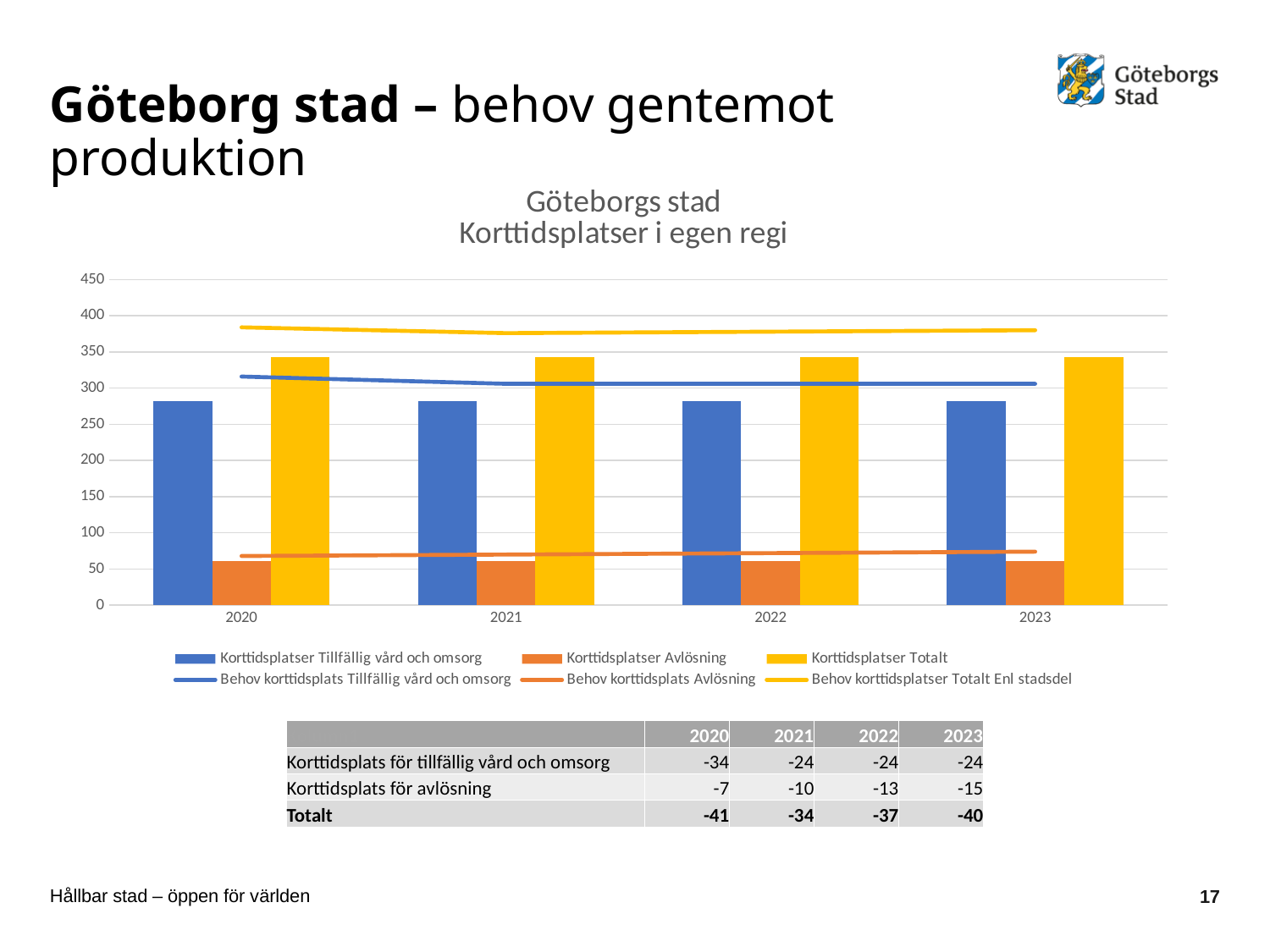
Is the value of the Korttidsplatser Avlösning bar for 2022 greater or less than 100? less What is the title of the chart? Göteborgs stad Korttidsplatser i egen regi How many years are shown on the x axis of the chart? 4 Is the value of the Korttidsplatser Totalt bar for 2020 greater or less than 300? greater Does the Behov korttidsplats Tillfällig vård och omsorg line rise or fall from 2020 to 2021? fall In 2020, which is larger: the Korttidsplatser Totalt bar or the Korttidsplatser Tillfällig vård och omsorg bar? Korttidsplatser Totalt Is the value of the Korttidsplatser Tillfällig vård och omsorg bar for 2021 greater or less than 300? less Which bar series has the highest values in the chart? Korttidsplatser Totalt How many series does the chart legend list? 6 What kind of chart is shown on the slide? Combined bar and line chart Which bar series has the lowest values in the chart? Korttidsplatser Avlösning